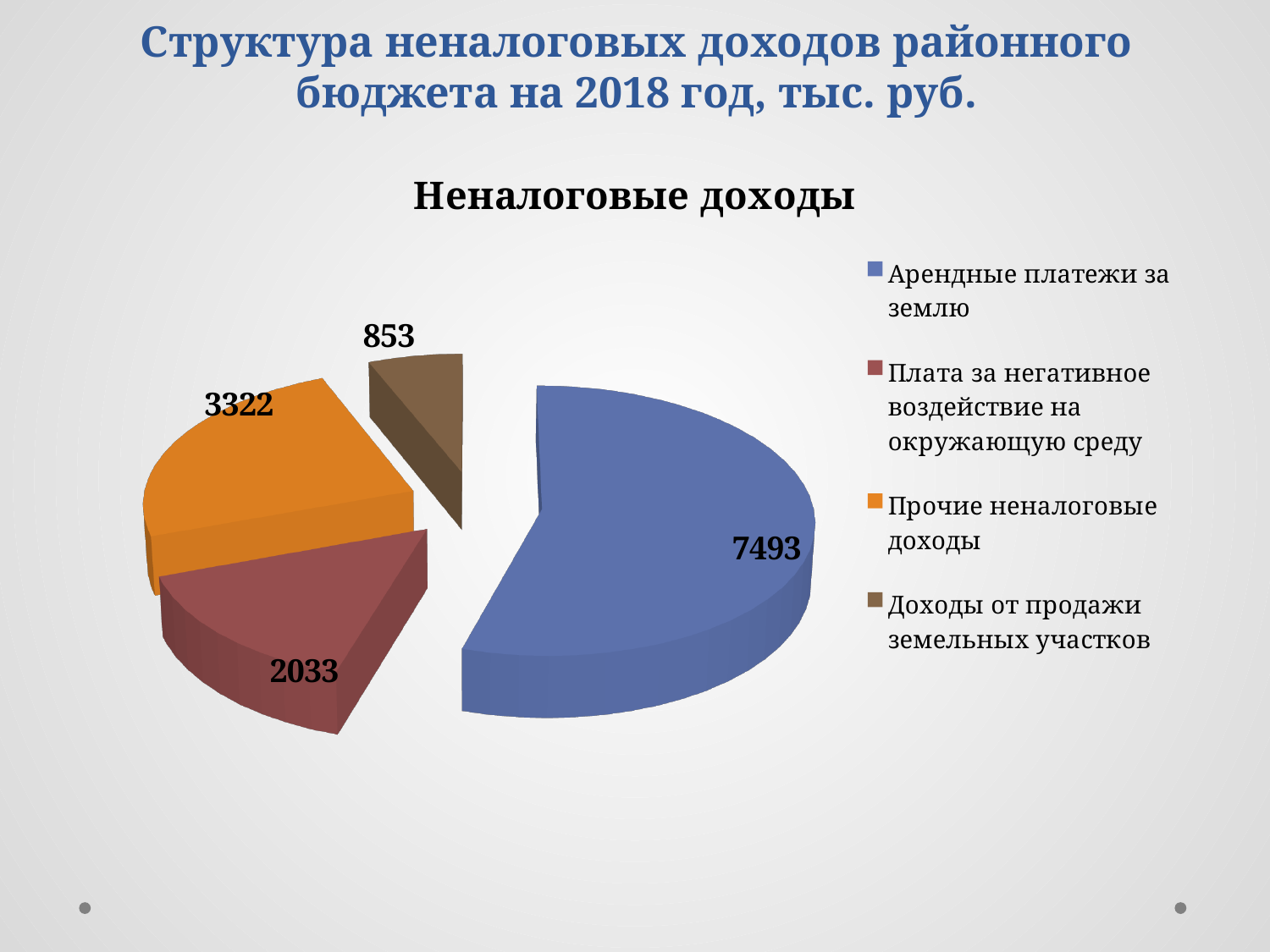
Which category has the largest slice of the pie? Арендные платежи за землю What is the value for Прочие неналоговые доходы? 3322 What is the title of the chart? Неналоговые доходы How many categories does the pie chart show? 4 What is the value for Доходы от продажи земельных участков? 853 Which category has the smallest slice of the pie? Доходы от продажи земельных участков What is the value for Плата за негативное воздействие на окружающую среду? 2033 Which is larger: Прочие неналоговые доходы or Плата за негативное воздействие на окружающую среду? Прочие неналоговые доходы What kind of chart is shown on the slide? Pie chart What is the value for Арендные платежи за землю? 7493 What is the difference between Арендные платежи за землю and Прочие неналоговые доходы? 4171 What is the difference between Прочие неналоговые доходы and Плата за негативное воздействие на окружающую среду? 1289